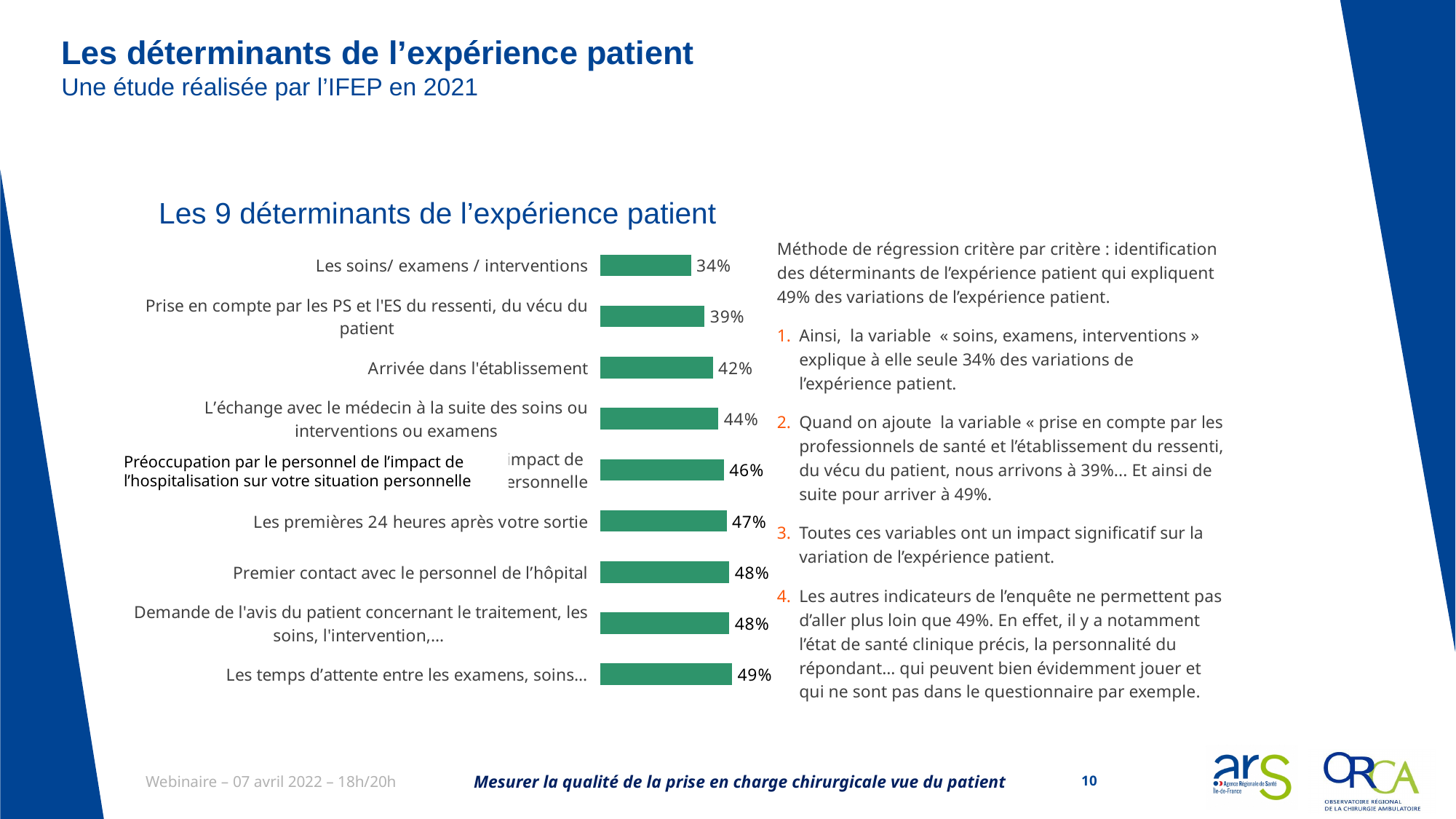
How many categories are plotted in the chart? 9 Which category has the highest value in the chart? Les temps d'attente entre les examens, soins... What value is shown for "Arrivée dans l'établissement"? 42% What is the title of the chart? Les 9 déterminants de l'expérience patient What value is shown for "Les premières 24 heures après votre sortie"? 47% Which is larger: the value for "Arrivée dans l'établissement" or the value for "Les premières 24 heures après votre sortie"? Les premières 24 heures après votre sortie What is the difference between the value for "Les temps d'attente entre les examens, soins..." and the value for "Les soins/ examens / interventions"? 15% What value is shown for "Les soins/ examens / interventions"? 34% What kind of chart is shown on the slide? Bar chart Do the values increase or decrease going from the top bar to the bottom bar? Increase What value is shown for "Premier contact avec le personnel de l'hôpital"? 48% Which category has the lowest value in the chart? Les soins/ examens / interventions